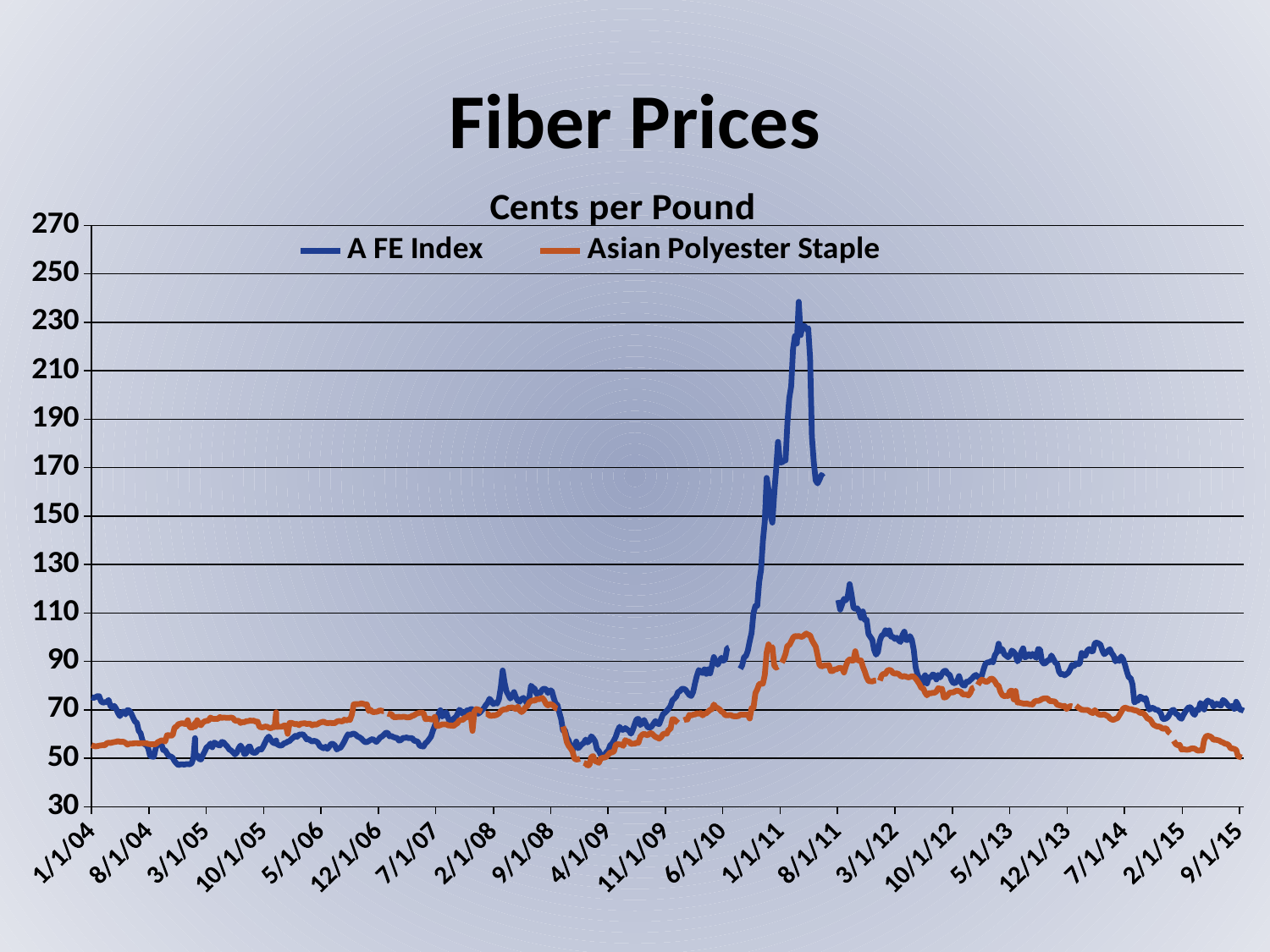
What kind of chart is shown on the slide? line chart How many series does the legend list? 2 Around 1/1/11, which series is higher, A FE Index or Asian Polyester Staple? A FE Index Is the peak value of the A FE Index greater or less than 210? greater What are the two series named in the legend? A FE Index and Asian Polyester Staple Around 3/1/05, which series is higher, A FE Index or Asian Polyester Staple? Asian Polyester Staple Is the A FE Index value around 3/1/05 greater or less than 70? less Which series reaches the highest value anywhere on the chart? A FE Index What is the title printed above the chart's plot area? Cents per Pound Is the A FE Index value around 8/1/11 greater or less than 130? less Does the Asian Polyester Staple line rise or fall between 7/1/14 and 9/1/15? fall